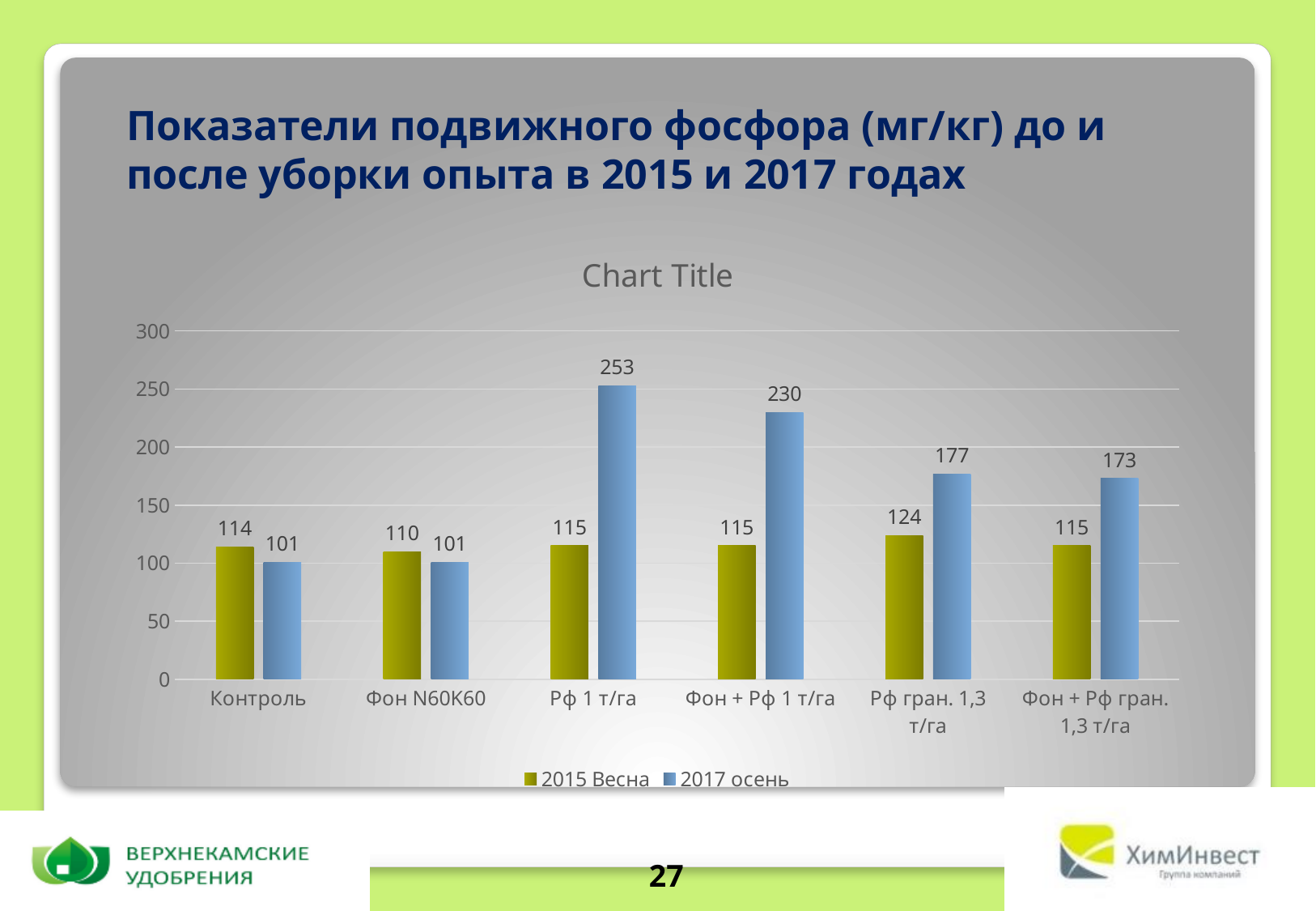
Which category has the highest "2017 осень" value? Рф 1 т/га How many series does the legend list? 2 What is the value for "2017 осень" in the "Фон + Рф гран. 1,3 т/га" category? 173 What is the value for "2017 осень" in the "Рф 1 т/га" category? 253 What is the difference between the "2017 осень" and "2015 Весна" values for "Фон + Рф 1 т/га"? 115 What are the two series names listed in the legend? 2015 Весна and 2017 осень What is the value for "2015 Весна" in the "Контроль" category? 114 How many categories are shown on the x axis? 6 Which category has the lowest "2015 Весна" value? Фон N60K60 Which is larger for "Контроль": the "2015 Весна" value or the "2017 осень" value? 2015 Весна Is the "2017 осень" value for "Рф гран. 1,3 т/га" greater or less than 150? greater What kind of chart is shown on the slide? bar chart